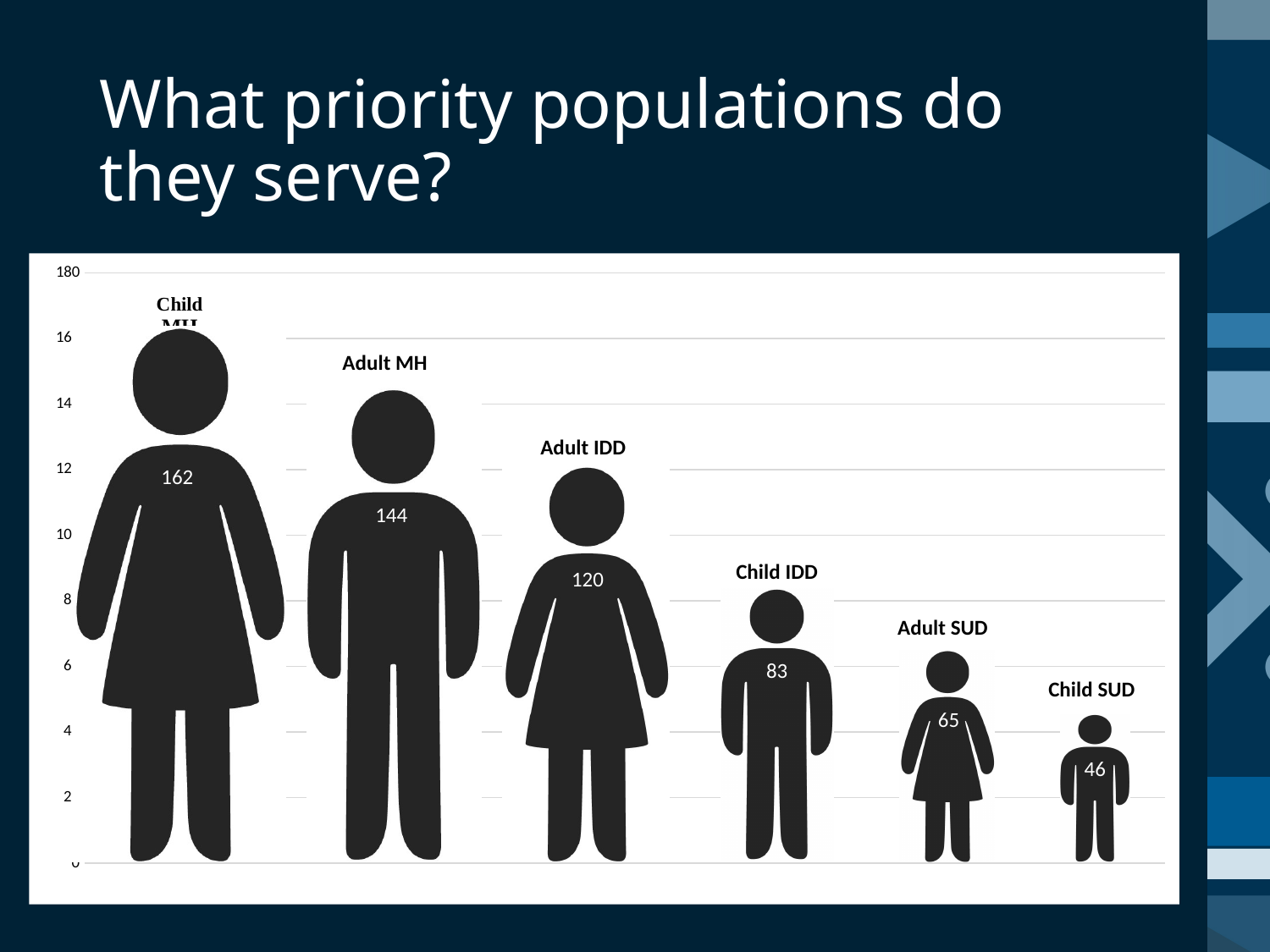
Which is larger, the value for Adult IDD or the value for Child IDD? Adult IDD What is the difference between the values for Child IDD and Child SUD? 37 Which priority population has the lowest value? Child SUD What is the value for Adult SUD? 65 How many priority populations are shown in the chart? 6 What is the difference between the values for Child MH and Adult MH? 18 What is the value for Child MH? 162 Which priority population has the highest value? Child MH What is the value for Adult IDD? 120 Do the values rise or fall from left to right across the chart? fall What is the value for Child SUD? 46 What is the title of the slide containing the chart? What priority populations do they serve?